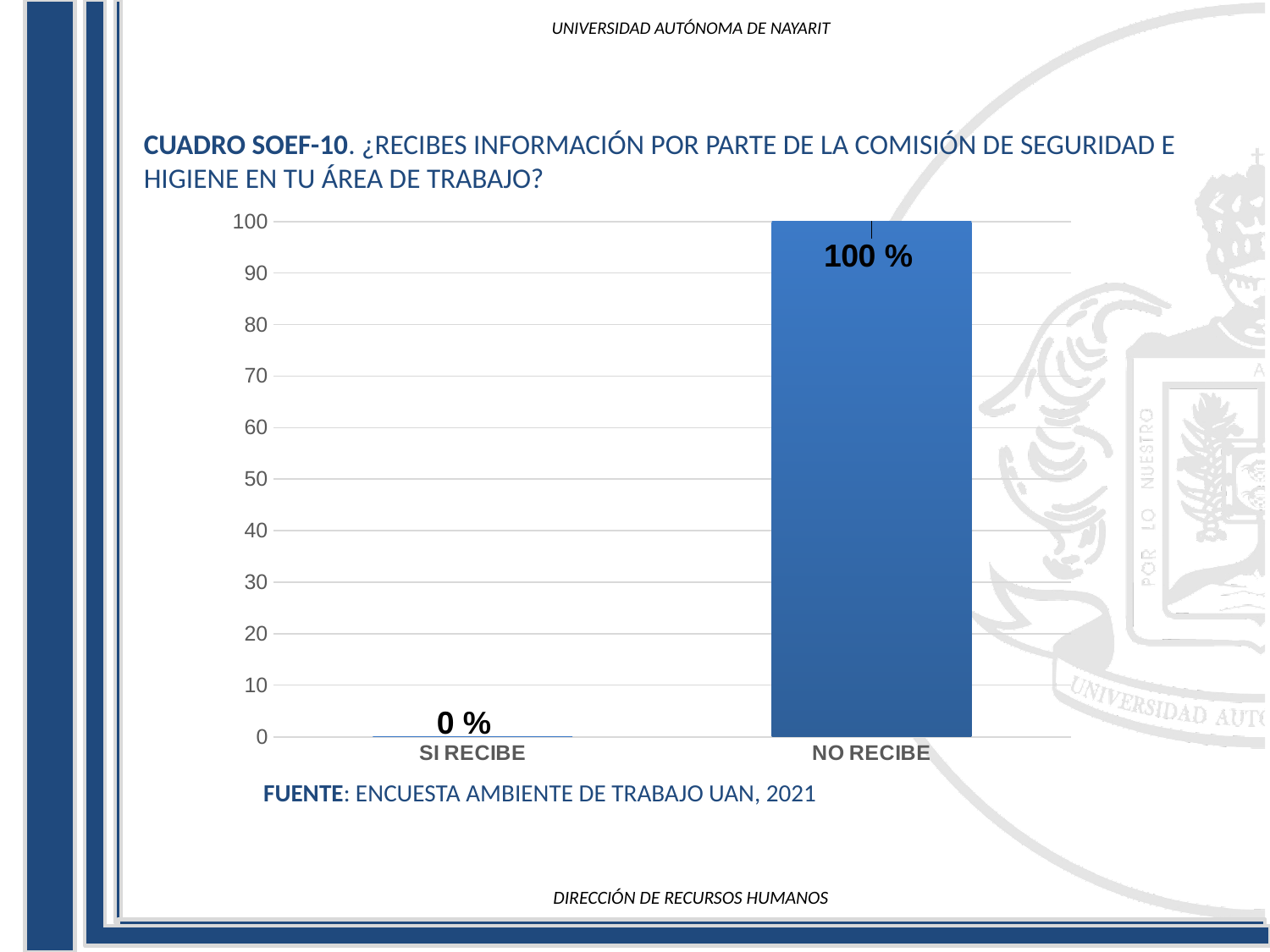
What is the highest value shown on the vertical axis? 100 What source is cited below the chart? ENCUESTA AMBIENTE DE TRABAJO UAN, 2021 What is the difference between the values for NO RECIBE and SI RECIBE? 100 % Which category has the highest value? NO RECIBE Which category has the lowest value? SI RECIBE Which is larger, the value for SI RECIBE or the value for NO RECIBE? NO RECIBE Is the value for NO RECIBE greater or less than 50? greater What kind of chart is shown on the slide? bar chart What is the value for NO RECIBE? 100 % How many categories are shown on the x axis? 2 What is the value for SI RECIBE? 0 %